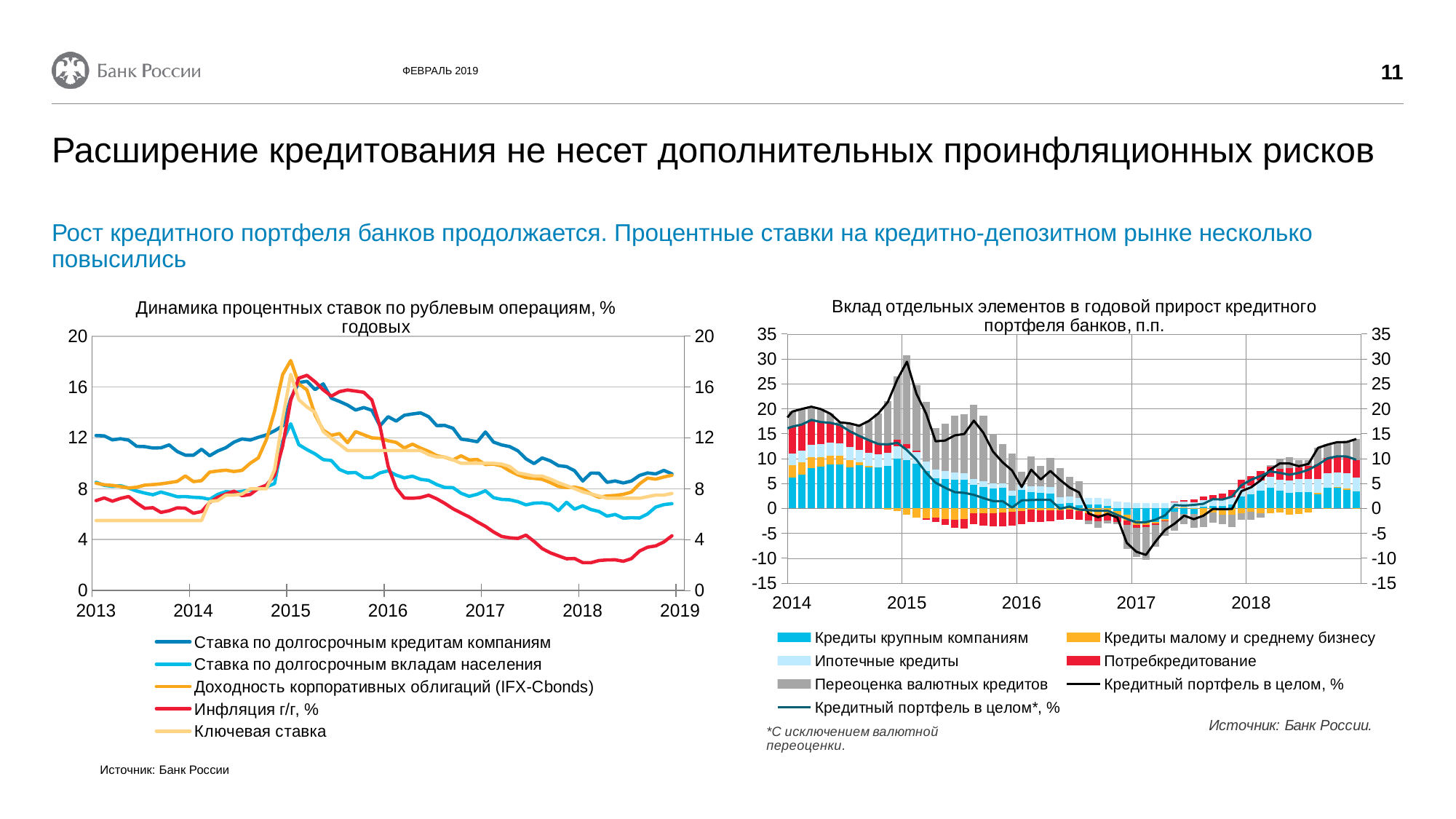
What is the title of the right chart? Вклад отдельных элементов в годовой прирост кредитного портфеля банков, п.п. What kind of chart is the left chart, 'Динамика процентных ставок по рублевым операциям, % годовых'? line chart How many entries does the legend of the right chart, 'Вклад отдельных элементов в годовой прирост кредитного портфеля банков, п.п.', list? 7 In the left chart, which is higher at the start of 2013: 'Ставка по долгосрочным кредитам компаниям' or 'Ключевая ставка'? Ставка по долгосрочным кредитам компаниям In the left chart, does 'Инфляция г/г, %' rise or fall between 2015 and 2018? fall In the left chart, is the value of 'Инфляция г/г, %' at the start of 2018 greater or less than 4? less In the right chart, is the peak of 'Кредитный портфель в целом, %' in 2015 greater or less than 25? greater How many series does the legend of the left chart list? 5 In the left chart, is the value of 'Ключевая ставка' at the start of 2013 greater or less than 8? less In the right chart, does 'Кредитный портфель в целом, %' rise or fall between 2017 and the end of 2018? rise